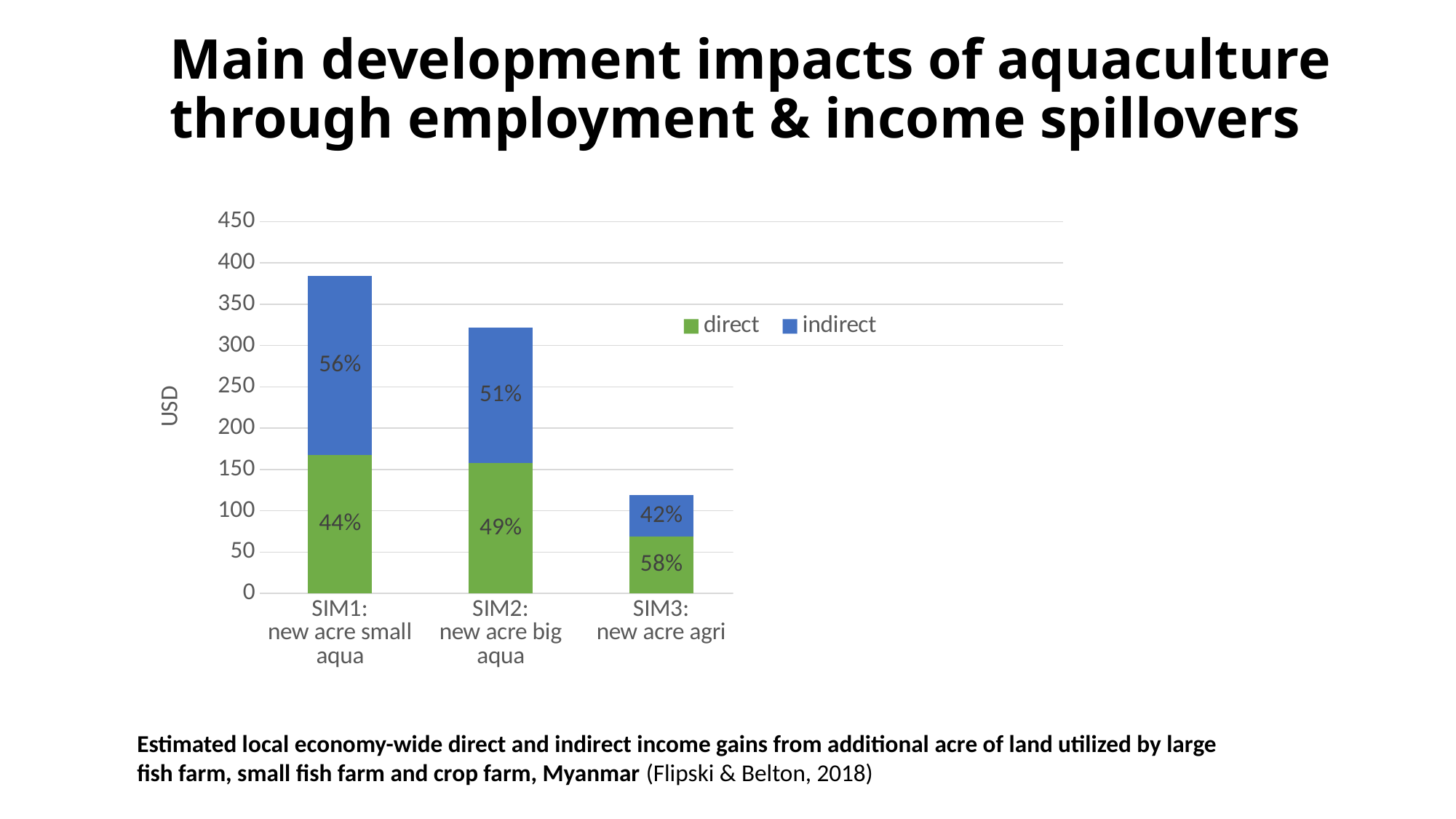
What percentage label is shown on the direct segment of the SIM1: new acre small aqua bar? 44% What percentage label is shown on the indirect segment of the SIM2: new acre big aqua bar? 51% Is the total value for SIM3: new acre agri greater or less than 150? less Is the total value for SIM1: new acre small aqua greater or less than 350? greater What kind of chart is shown on the slide? bar chart How many series does the legend list? 2 Which category has the shortest total bar? SIM3: new acre agri What percentage label is shown on the direct segment of the SIM3: new acre agri bar? 58% How many categories (simulations) are shown on the x axis? 3 Which category has the tallest total bar? SIM1: new acre small aqua What is the label on the y axis? USD Which has the larger direct segment, SIM2: new acre big aqua or SIM3: new acre agri? SIM2: new acre big aqua